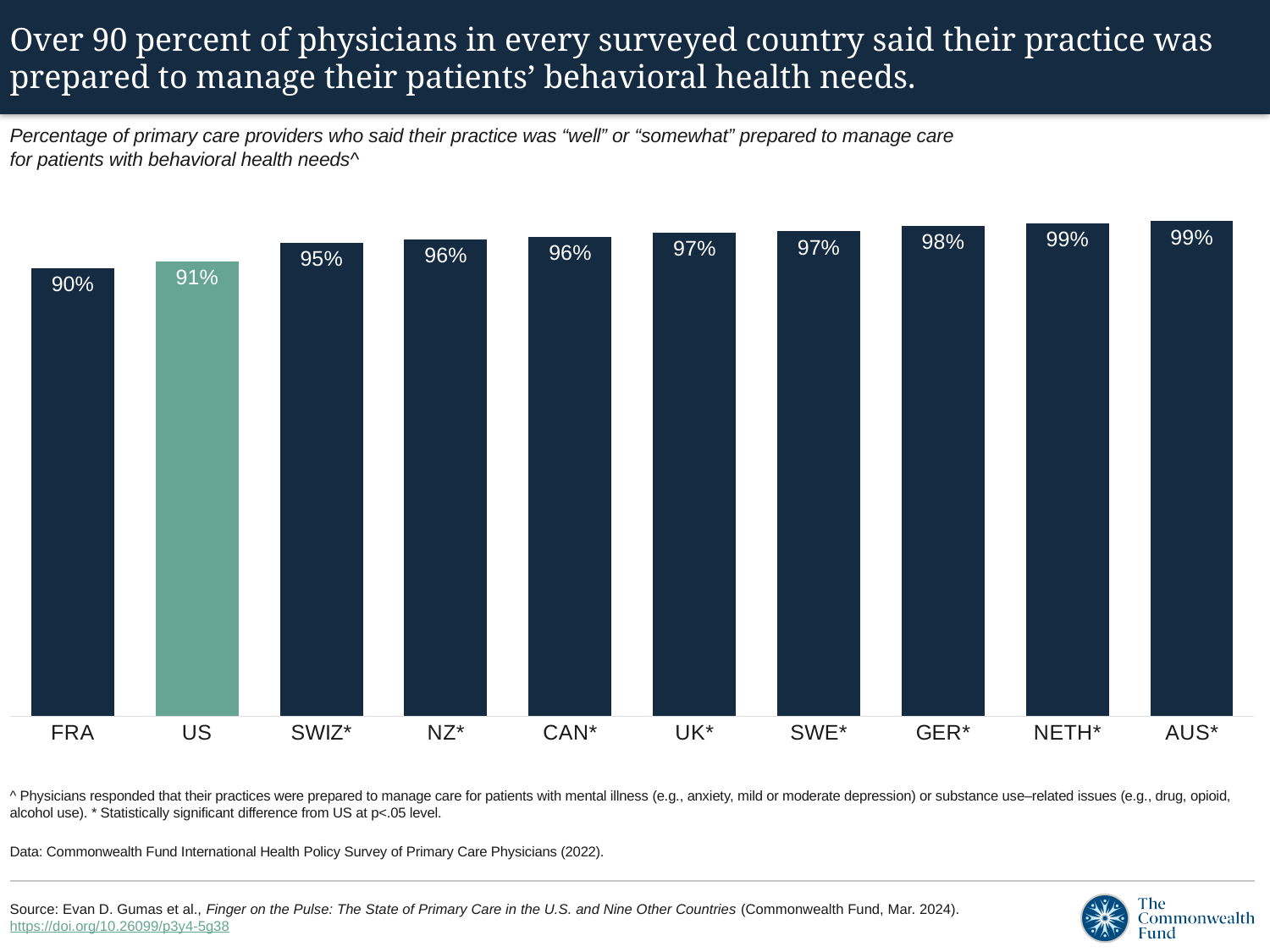
What is the value shown for GER*? 98% What is the value shown for SWIZ*? 95% Which has a higher value, NZ* or US? NZ* What is the value shown for UK*? 97% What is the difference between the values for GER* and US? 7 percentage points What is the highest value shown in the chart? 99% What type of chart is shown on the slide? Bar chart What is the difference between the values for AUS* and FRA? 9 percentage points How many countries are shown in the chart? 10 What percentage of primary care providers in the US said their practice was prepared to manage care for patients with behavioral health needs? 91% Which country has the lowest percentage in the chart? FRA Which country's bar is shown in a different colour (green) from the others? US